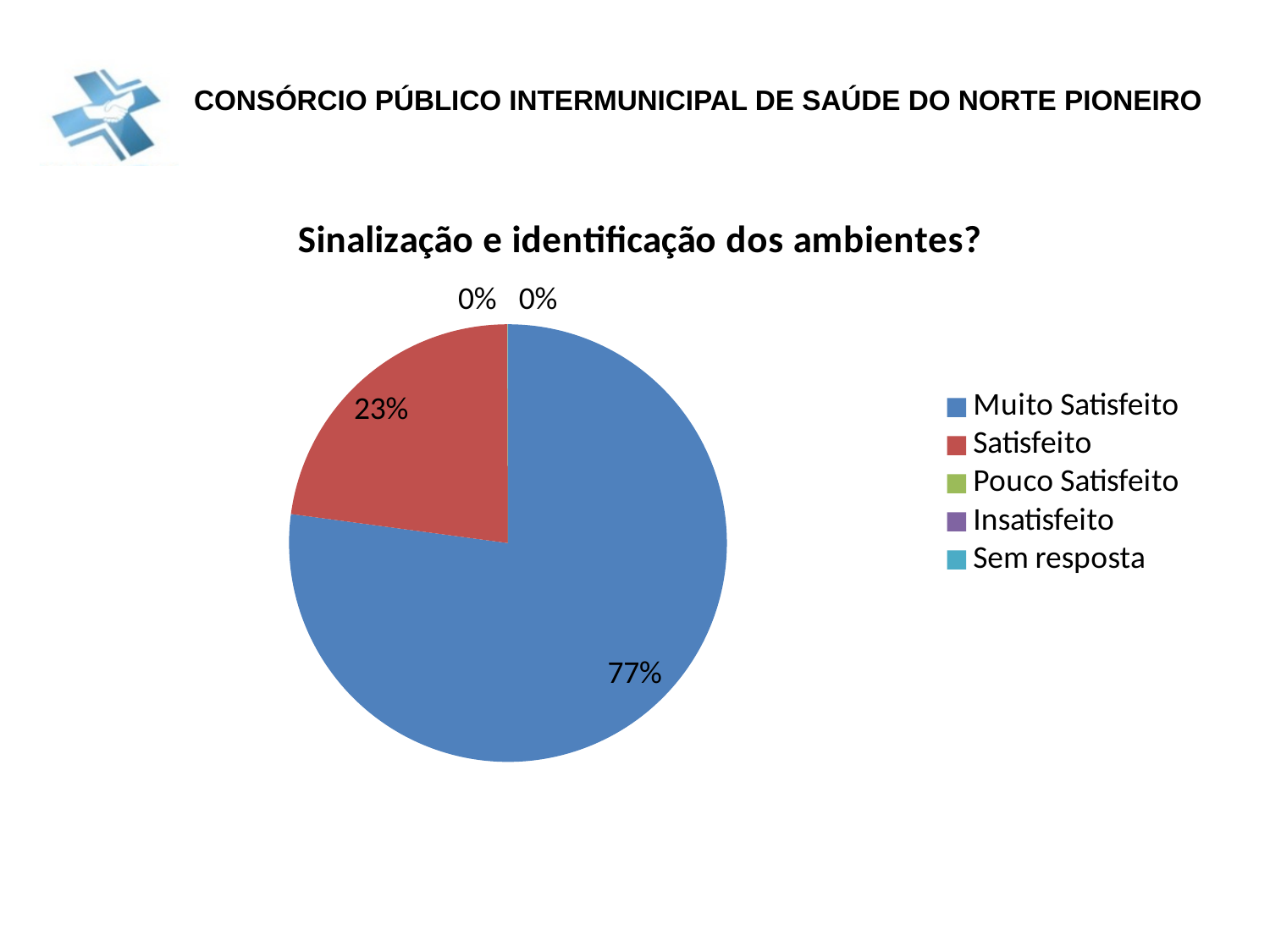
What share of the pie is Pouco Satisfeito? 0% How many entries does the legend list? 5 What share of the pie is Muito Satisfeito? 77% Which category has the largest share of the pie? Muito Satisfeito What colour is the Satisfeito slice? red What is the title of the chart? Sinalização e identificação dos ambientes? What is the difference between the Muito Satisfeito share and the Satisfeito share? 54% Which is larger, the share for Muito Satisfeito or the share for Satisfeito? Muito Satisfeito What share of the pie is Satisfeito? 23% What type of chart is shown on the slide? pie chart What is the combined share of Muito Satisfeito and Satisfeito? 100% Is the share for Muito Satisfeito greater or less than 50%? greater